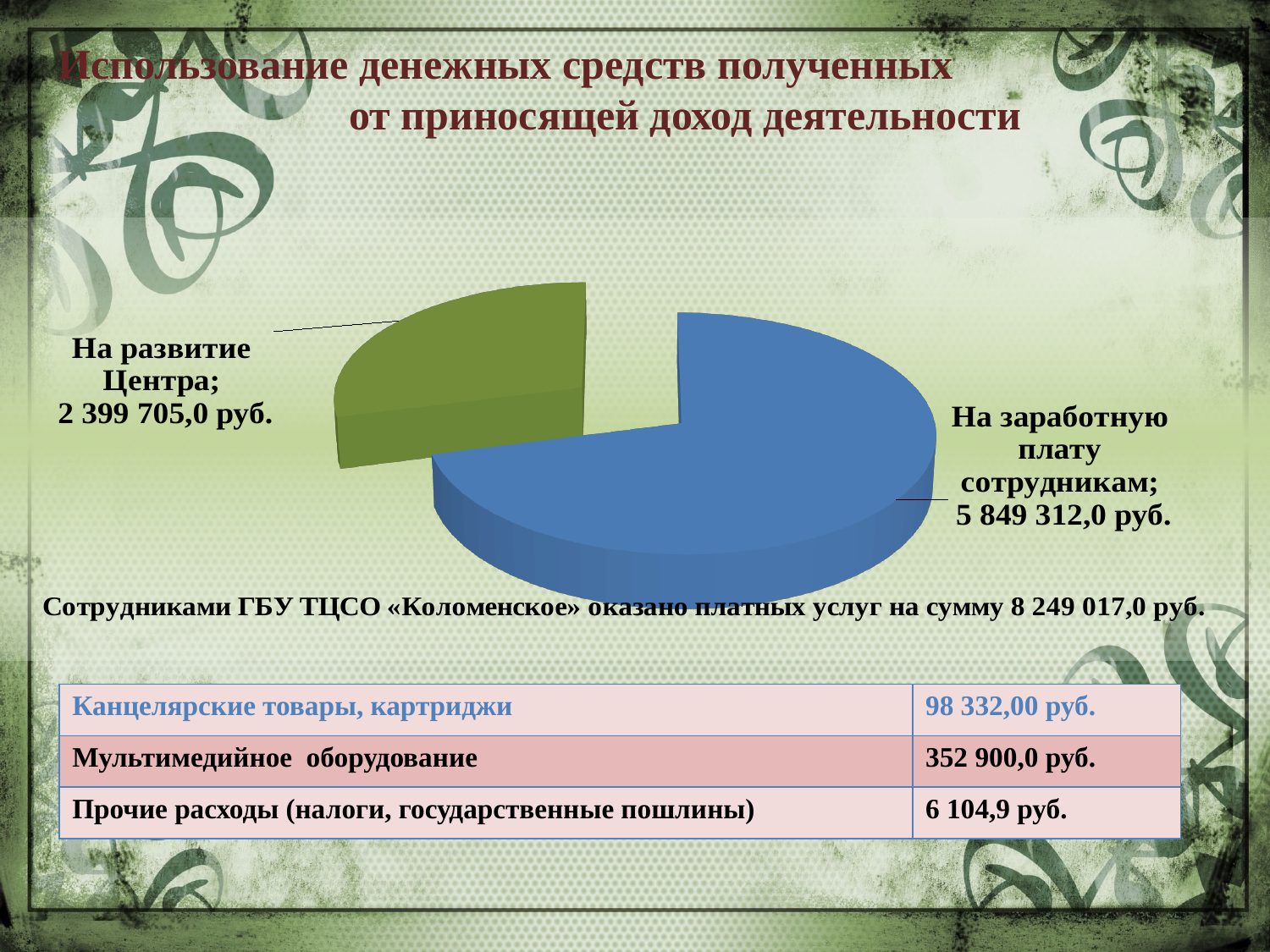
Which is larger: the amount for "На развитие Центра" or the amount for "На заработную плату сотрудникам"? На заработную плату сотрудникам What is the difference between the amount for "На заработную плату сотрудникам" and the amount for "На развитие Центра"? 3 449 607,0 руб. What is the total of the two slices in the pie chart? 8 249 017,0 руб. What colour is the slice for "На развитие Центра"? Green What value is shown for the slice "На развитие Центра"? 2 399 705,0 руб. What share of the pie does "На заработную плату сотрудникам" represent, to one decimal place? 70.9% Which category has the largest slice of the pie? На заработную плату сотрудникам Which category has the smallest slice of the pie? На развитие Центра What value is shown for the slice "На заработную плату сотрудникам"? 5 849 312,0 руб. How many slices does the pie chart have? 2 What kind of chart is shown on the slide? Pie chart What colour is the slice for "На заработную плату сотрудникам"? Blue